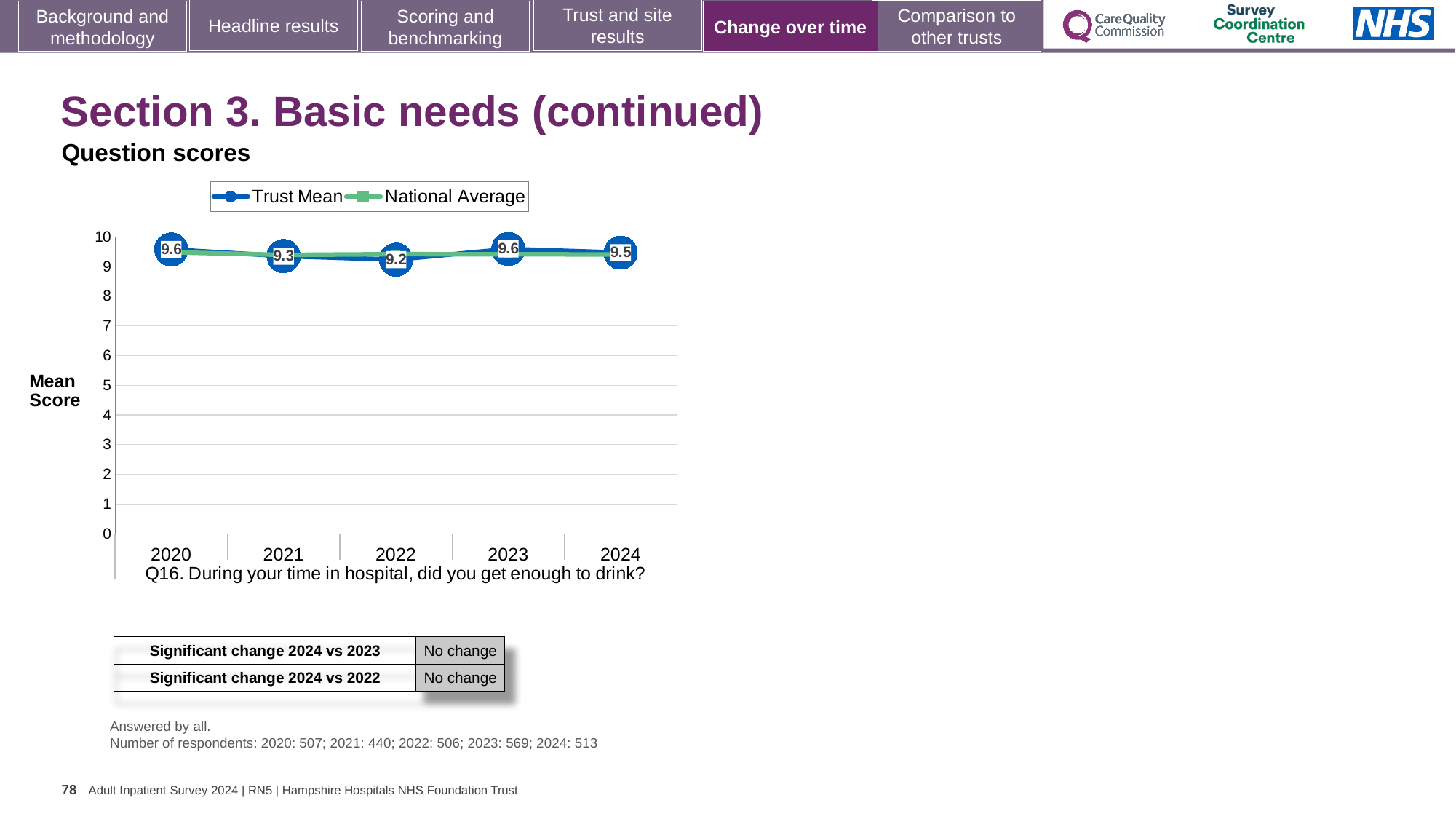
What is the Trust Mean score for 2020? 9.6 How many years are plotted on the x axis? 5 What is the difference between the Trust Mean score in 2020 and in 2022? 0.4 Which year has the larger Trust Mean score, 2021 or 2022? 2021 Is the National Average value for 2024 greater or less than 8? greater How many series does the legend list? 2 What is the Trust Mean score for 2021? 9.3 Does the Trust Mean score rise or fall from 2021 to 2022? Fall What is the Trust Mean score for 2024? 9.5 What kind of chart is shown on the slide? Line chart What is the Trust Mean score for 2022? 9.2 In which year is the Trust Mean score lowest? 2022